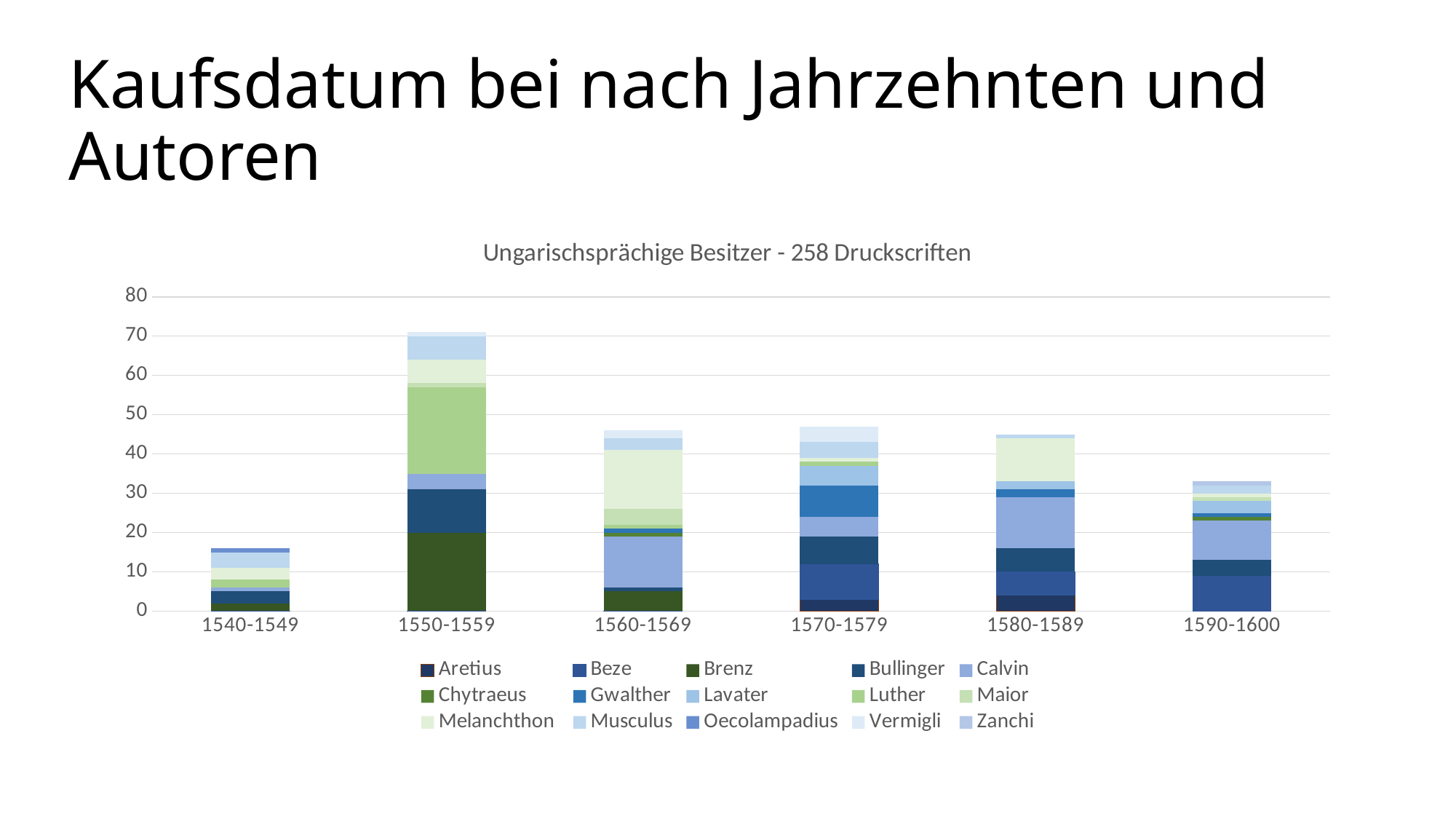
Which decade has the highest total stacked bar? 1550-1559 What is the title of the chart? Ungarischsprächige Besitzer - 258 Druckscriften Which has the larger total, 1540-1549 or 1560-1569? 1560-1569 How many series (authors) does the legend list? 15 How many decade categories are shown on the x axis? 6 Which has the larger total, 1580-1589 or 1590-1600? 1580-1589 Which decade has the lowest total stacked bar? 1540-1549 Is the total for 1550-1559 greater or less than 60? greater Is the total for 1570-1579 greater or less than 40? greater What kind of chart is shown on the slide? Stacked bar chart Is the total for 1580-1589 greater or less than 50? less